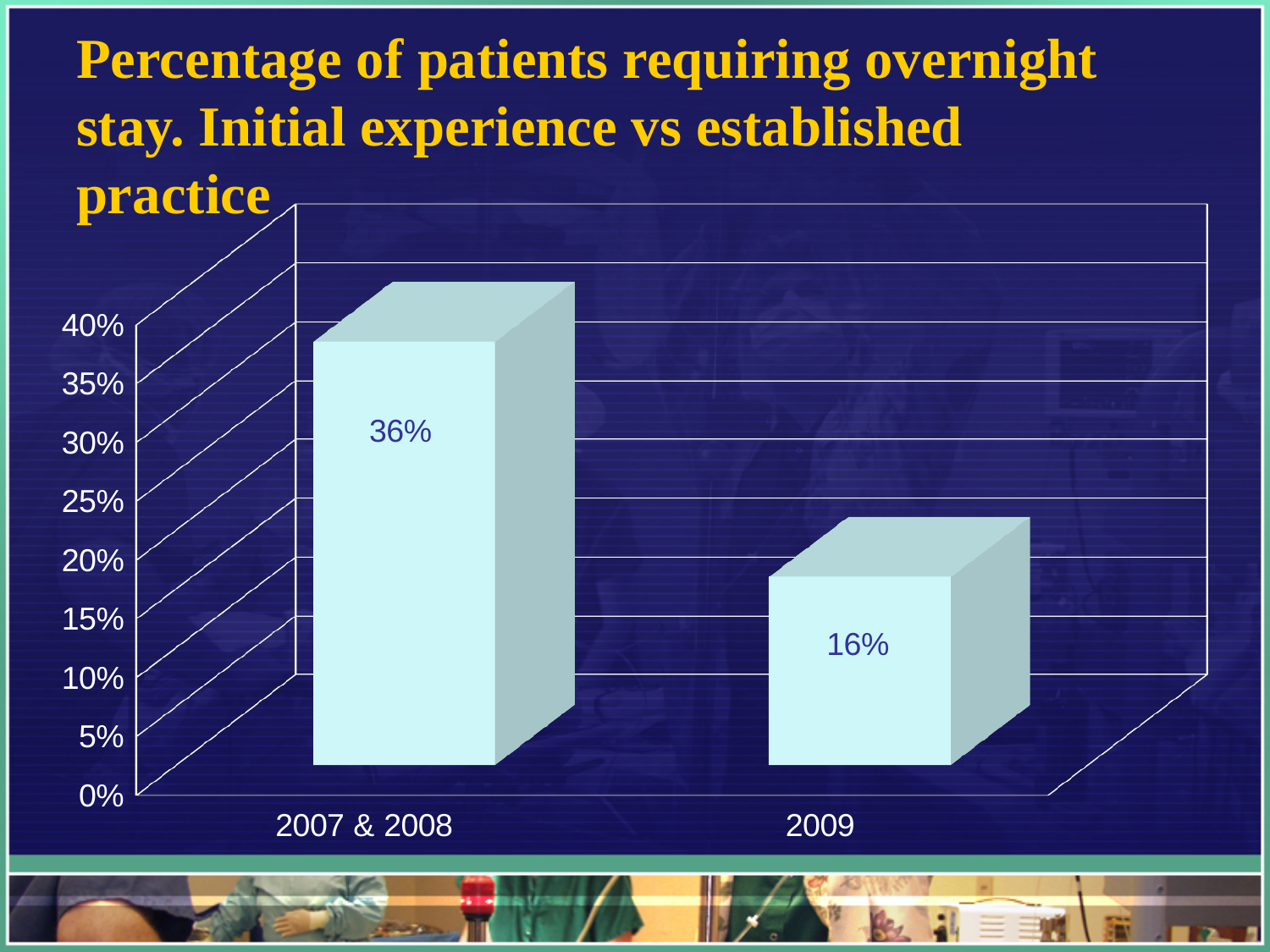
Which is larger, the value for 2007 & 2008 or the value for 2009? 2007 & 2008 Is the value for 2007 & 2008 greater or less than 30%? greater Which category has the highest percentage of patients requiring overnight stay? 2007 & 2008 What is the percentage of patients requiring overnight stay for 2009? 16% Do the values rise or fall from 2007 & 2008 to 2009? Fall What is the highest value labelled on the y axis of the chart? 40% How many categories are shown on the x axis of the chart? 2 Which category has the lowest percentage of patients requiring overnight stay? 2009 What is the percentage of patients requiring overnight stay for 2007 & 2008? 36% Is the value for 2009 greater or less than 20%? less What is the difference between the percentage for 2007 & 2008 and the percentage for 2009? 20% What kind of chart is shown on the slide? Bar chart